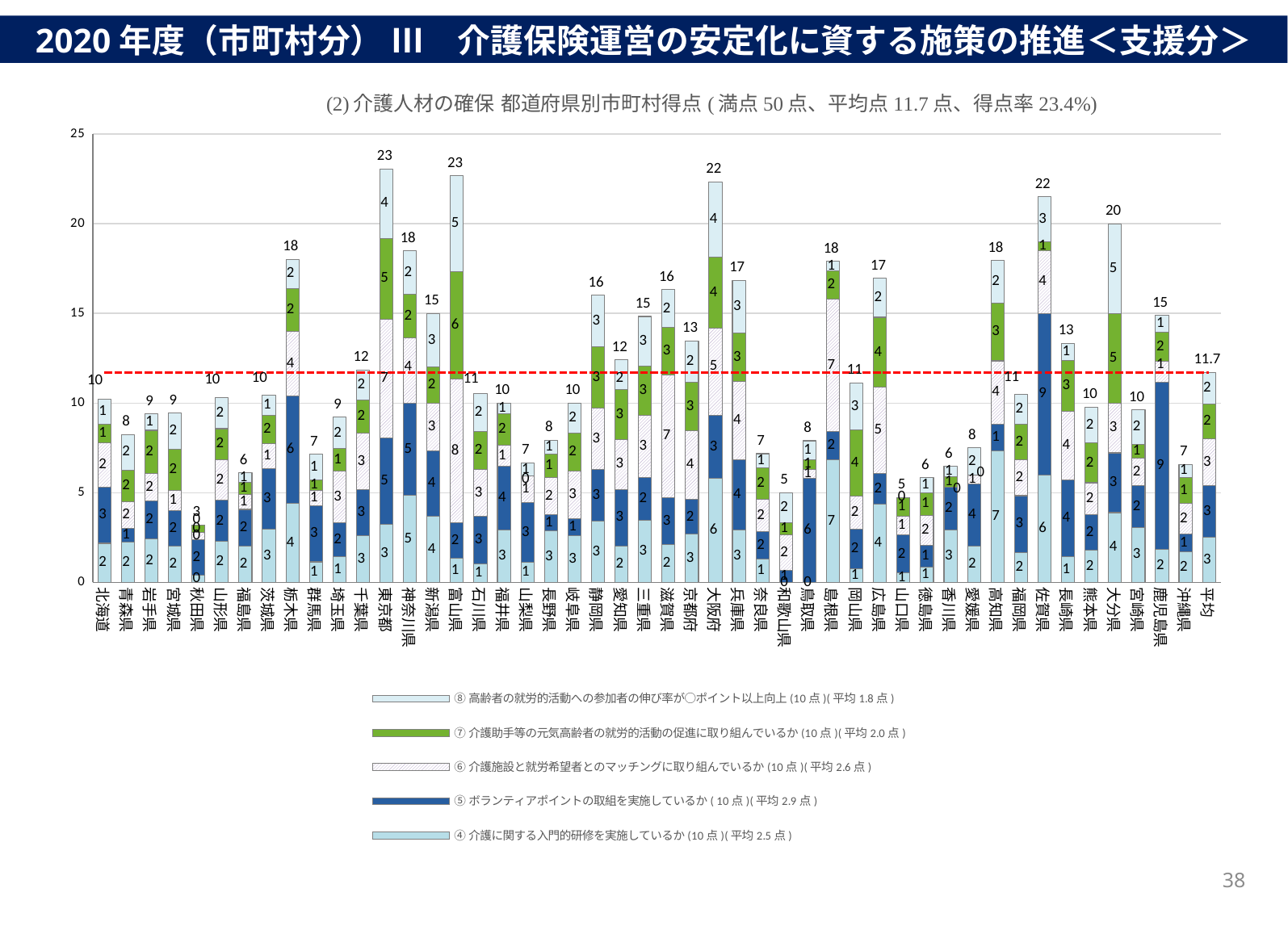
Is the total score for 和歌山県 greater or less than 10? less What is the value shown for 平均 (the average bar)? 11.7 What is the total score shown for 大阪府? 22 What is the difference between the total scores of 東京都 and 秋田県? 20 What value does the red dashed horizontal line mark? 11.7 Which has the higher total score, 栃木県 or 群馬県? 栃木県 What is the value of the ⑤ ボランティアポイント segment (dark blue) for 鹿児島県? 9 Which prefecture has the lowest total score? 秋田県 What kind of chart is shown on the slide? Stacked bar chart What is the total score shown for 秋田県? 3 What is the total score shown for 大分県? 20 How many series does the legend list? 5